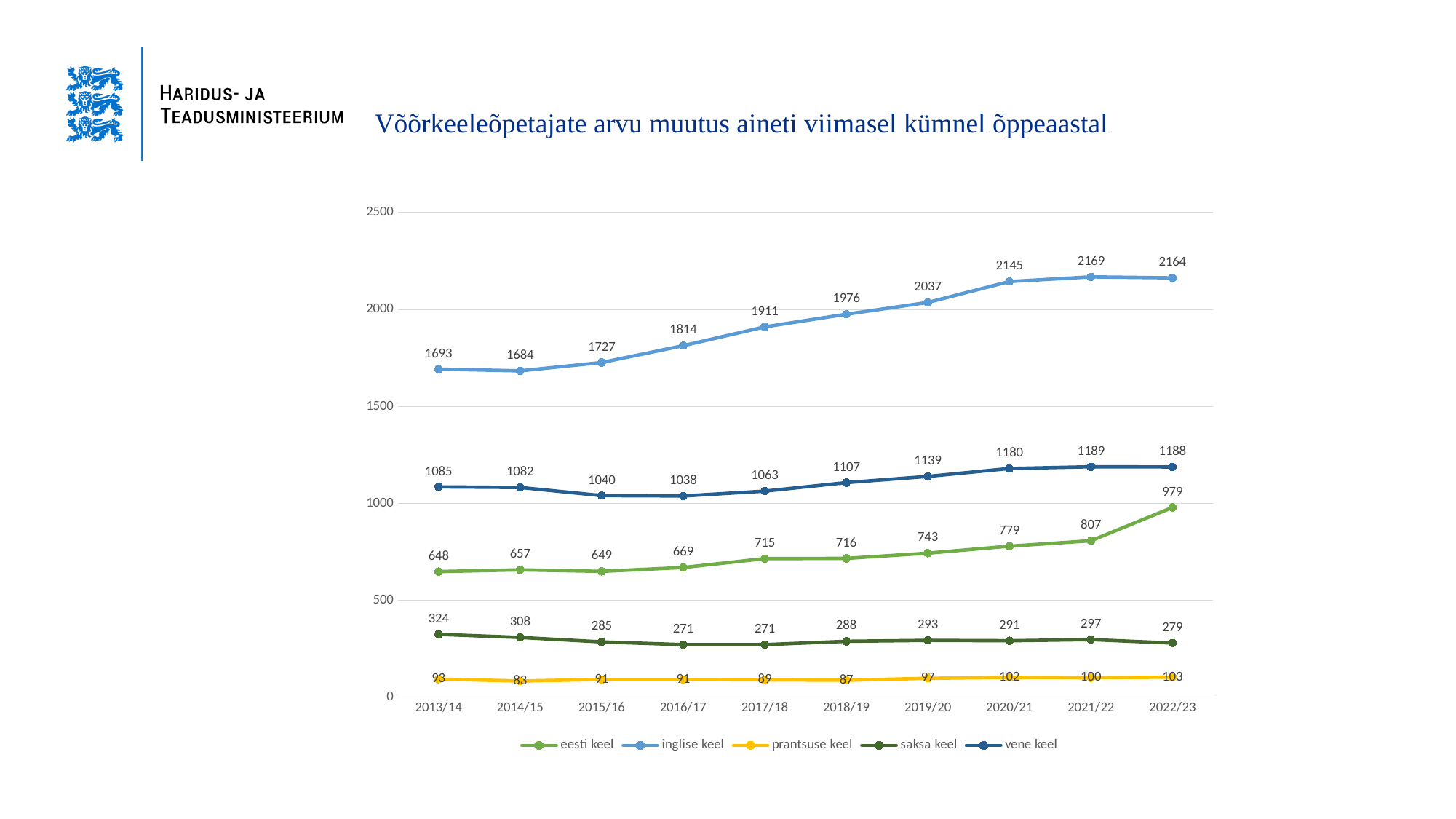
Does the value for eesti keel generally rise or fall from 2013/14 to 2022/23? rise In which school year is the value for vene keel lowest? 2016/17 What is the difference between the eesti keel values in 2022/23 and 2021/22? 172 What is the title of the chart? Võõrkeeleõpetajate arvu muutus aineti viimasel kümnel õppeaastal What is the value for saksa keel in 2016/17? 271 How many series does the legend list? 5 What is the value for eesti keel in 2013/14? 648 In which school year does inglise keel reach its highest value? 2021/22 Which is larger in 2019/20: the value for saksa keel or the value for prantsuse keel? saksa keel What is the value for inglise keel in 2022/23? 2164 How many school years are plotted along the x axis? 10 What type of chart is shown on the slide? line chart